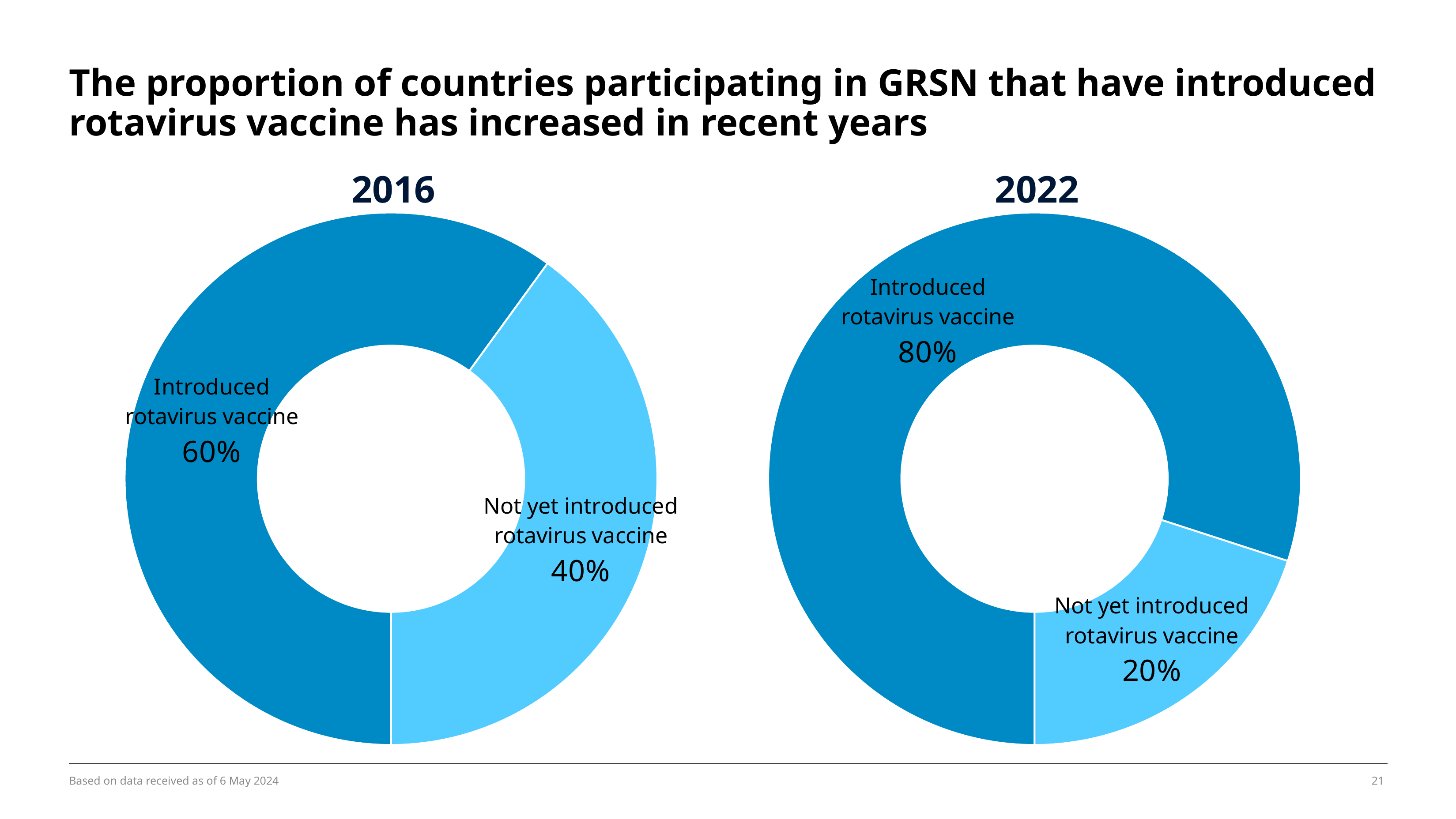
In the 2022 chart, which slice is the largest? Introduced rotavirus vaccine What kind of chart is used for the 2016 data? Pie (doughnut) chart How many charts are shown on the slide? 2 In the 2022 chart, what share of countries had introduced rotavirus vaccine? 80% Which is larger: the 'Not yet introduced rotavirus vaccine' share in 2016 or in 2022? 2016 In the 2016 chart, what share of countries had not yet introduced rotavirus vaccine? 40% In the 2022 chart, what share of countries had not yet introduced rotavirus vaccine? 20% How many slices does the 2022 chart have? 2 In the 2016 chart, which slice is the smallest? Not yet introduced rotavirus vaccine In the 2016 chart, what share of countries had introduced rotavirus vaccine? 60% In the 2016 chart, what is the difference between the 'Introduced' and 'Not yet introduced' shares? 20 percentage points What is the difference in percentage points between the 'Introduced rotavirus vaccine' share in 2022 and in 2016? 20 percentage points